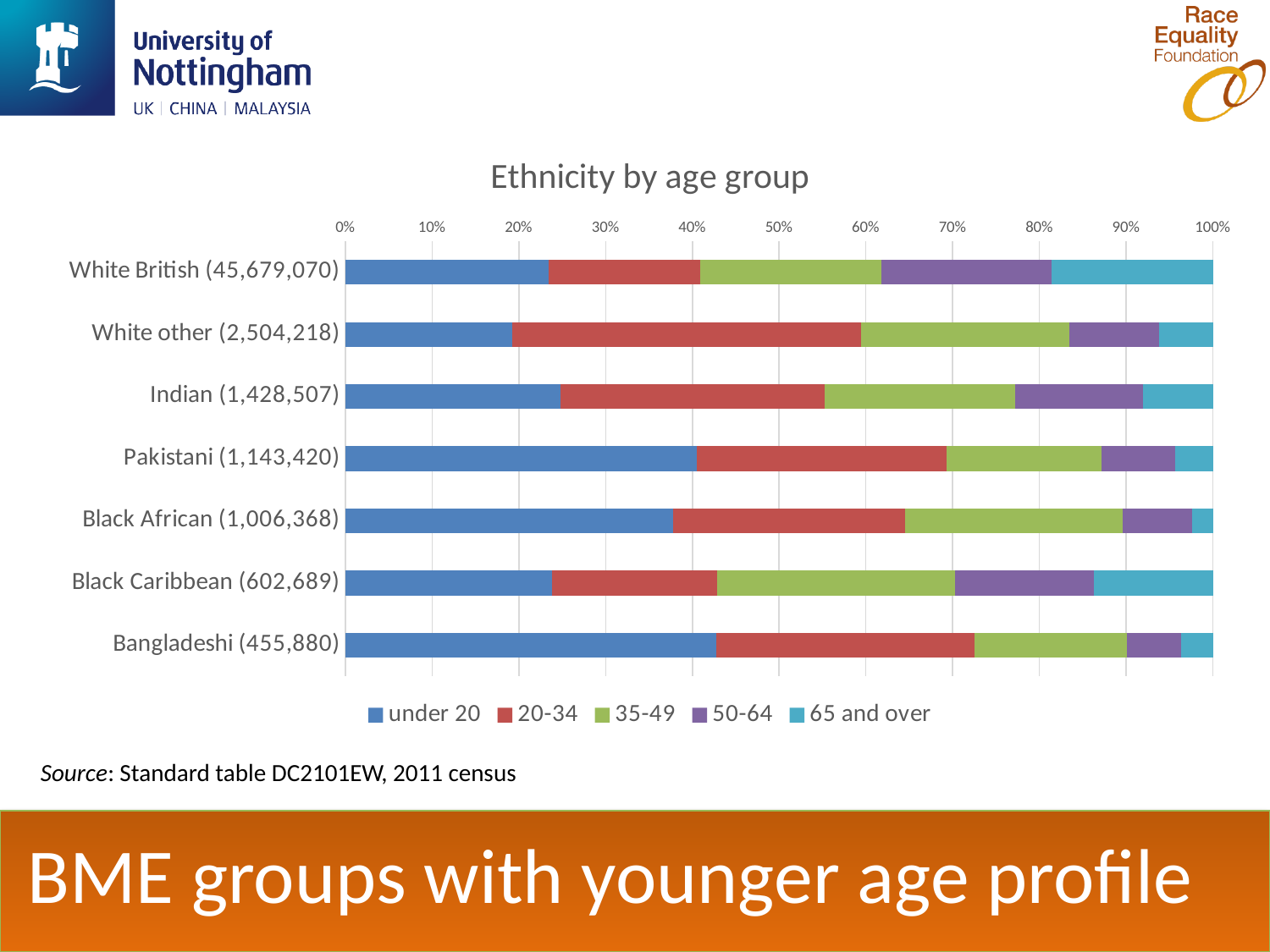
How many ethnic groups are plotted in the chart? 7 Is the under 20 share for White British (45,679,070) greater or less than 30%? less Which has the larger under 20 share: White British (45,679,070) or Black African (1,006,368)? Black African (1,006,368) What kind of chart is shown on the slide? bar chart Which ethnic group has the smallest under 20 share? White other (2,504,218) How many age-group series does the legend list? 5 Which ethnic group has the largest 65 and over share? White British (45,679,070) Which ethnic group has the smallest 65 and over share? Black African (1,006,368) Which age group is shown in red in the chart? 20-34 Is the under 20 share for Bangladeshi (455,880) greater or less than 40%? greater Is the under 20 share for Black African (1,006,368) greater or less than 30%? greater What is the title of the chart? Ethnicity by age group